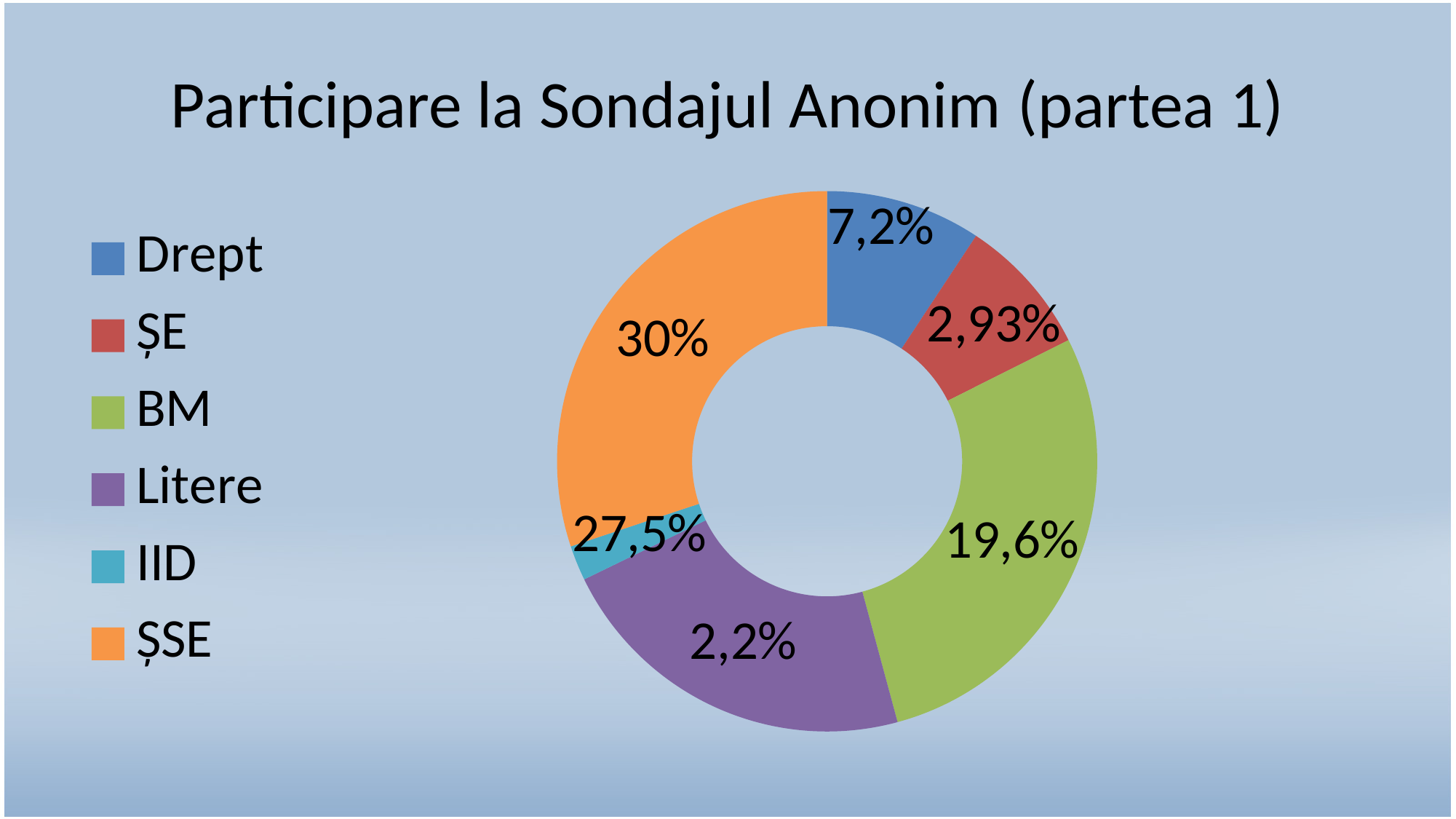
What percentage is shown for Drept? 7,2% What percentage is shown for ȘSE? 30% What is the title of the slide? Participare la Sondajul Anonim (partea 1) What is the difference between the ȘSE share and the BM share? 10,4% What percentage is shown for BM? 19,6% What kind of chart is shown on the slide? Doughnut (pie) chart Which is larger, the share for ȘSE or the share for BM? ȘSE What percentage is shown for Litere? 2,2% What percentage is shown for IID? 27,5% Which is larger, the share for Drept or the share for ȘE? Drept How many categories does the legend list? 6 What percentage is shown for ȘE? 2,93%